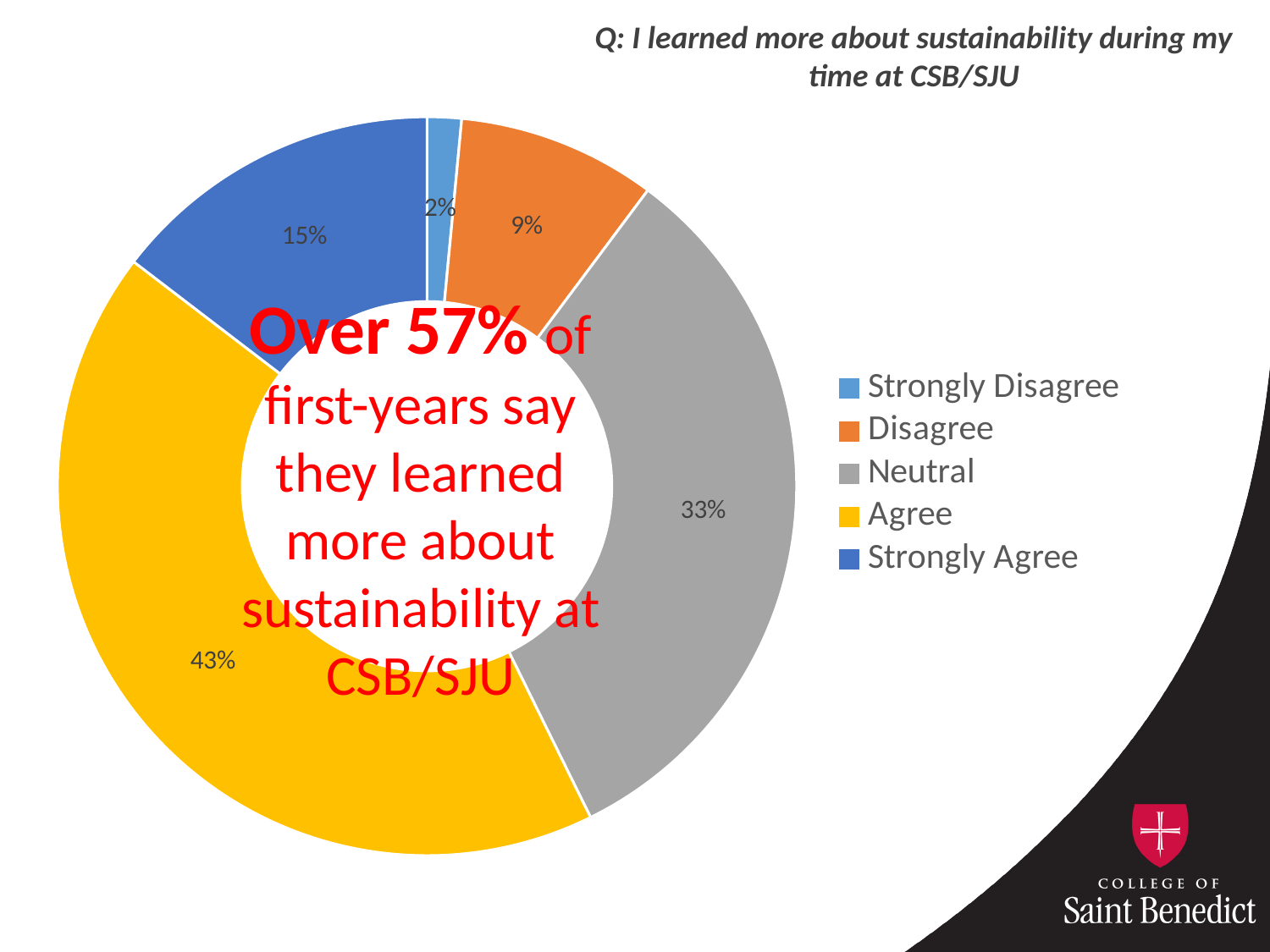
What percentage of respondents chose Disagree? 9% Which response category has the smallest share? Strongly Disagree What percentage of respondents chose Agree? 43% How many response categories does the legend list? 5 What percentage of respondents chose Strongly Disagree? 2% What colour represents the Neutral category? Gray What kind of chart is shown on the slide? Doughnut (pie) chart What is the difference in percentage points between Agree and Neutral? 10 Which is larger, the share for Strongly Agree or the share for Disagree? Strongly Agree What percentage of respondents chose Strongly Agree? 15% What percentage of respondents chose Neutral? 33% Which response category has the largest share? Agree